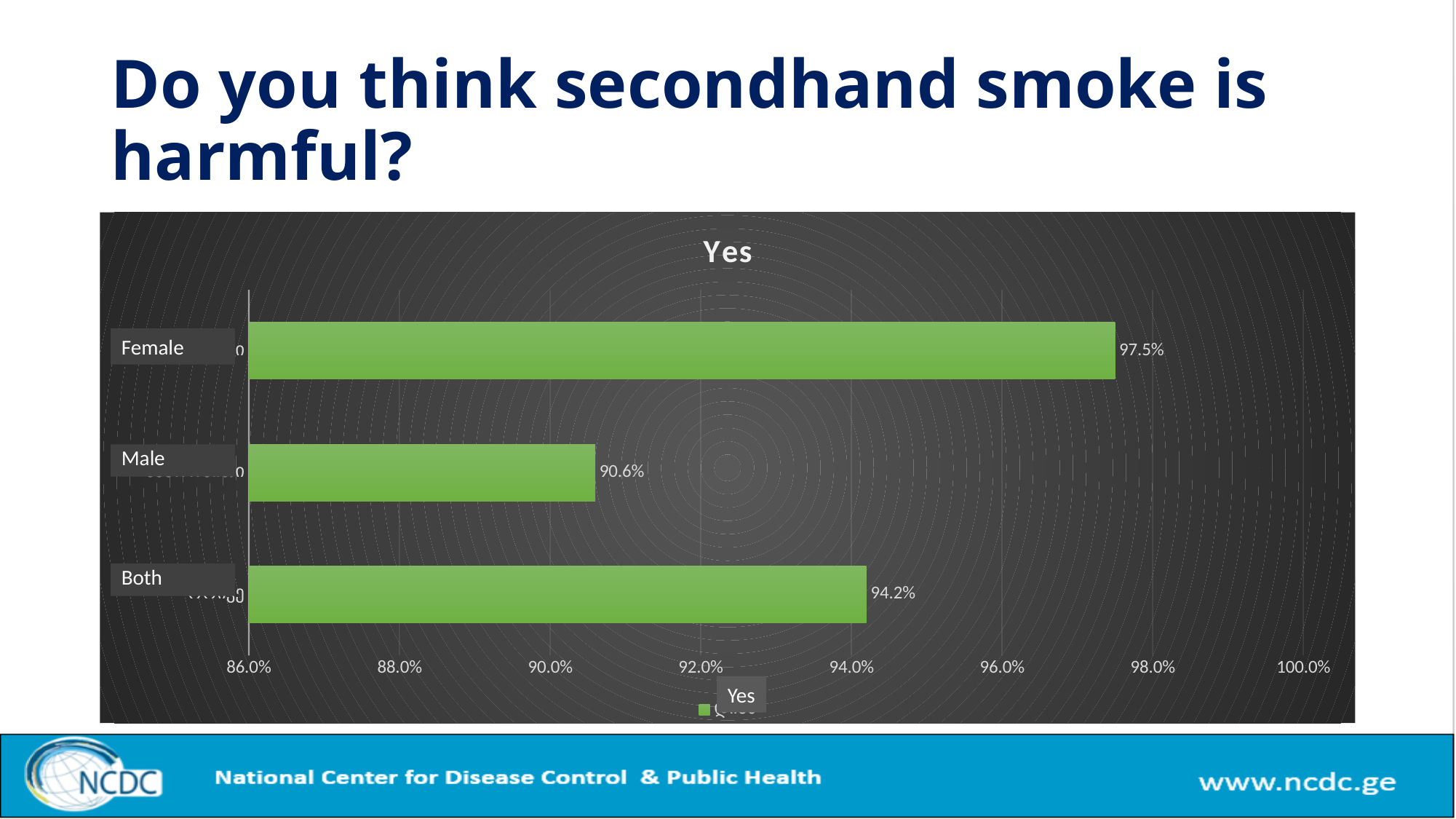
Is the value for Male greater or less than 92.0%? less What is the difference between the Female and Both values? 3.3% How many categories are shown in the chart? 3 What is the value for Both? 94.2% What percentage of males answered Yes? 90.6% What is the difference between the Female and Male values? 6.9% Which category has the highest value? Female Which is larger, the value for Male or the value for Both? Both What kind of chart is shown on the slide? bar chart Which category has the lowest value? Male What percentage of females answered Yes? 97.5% What is the title of the chart? Yes